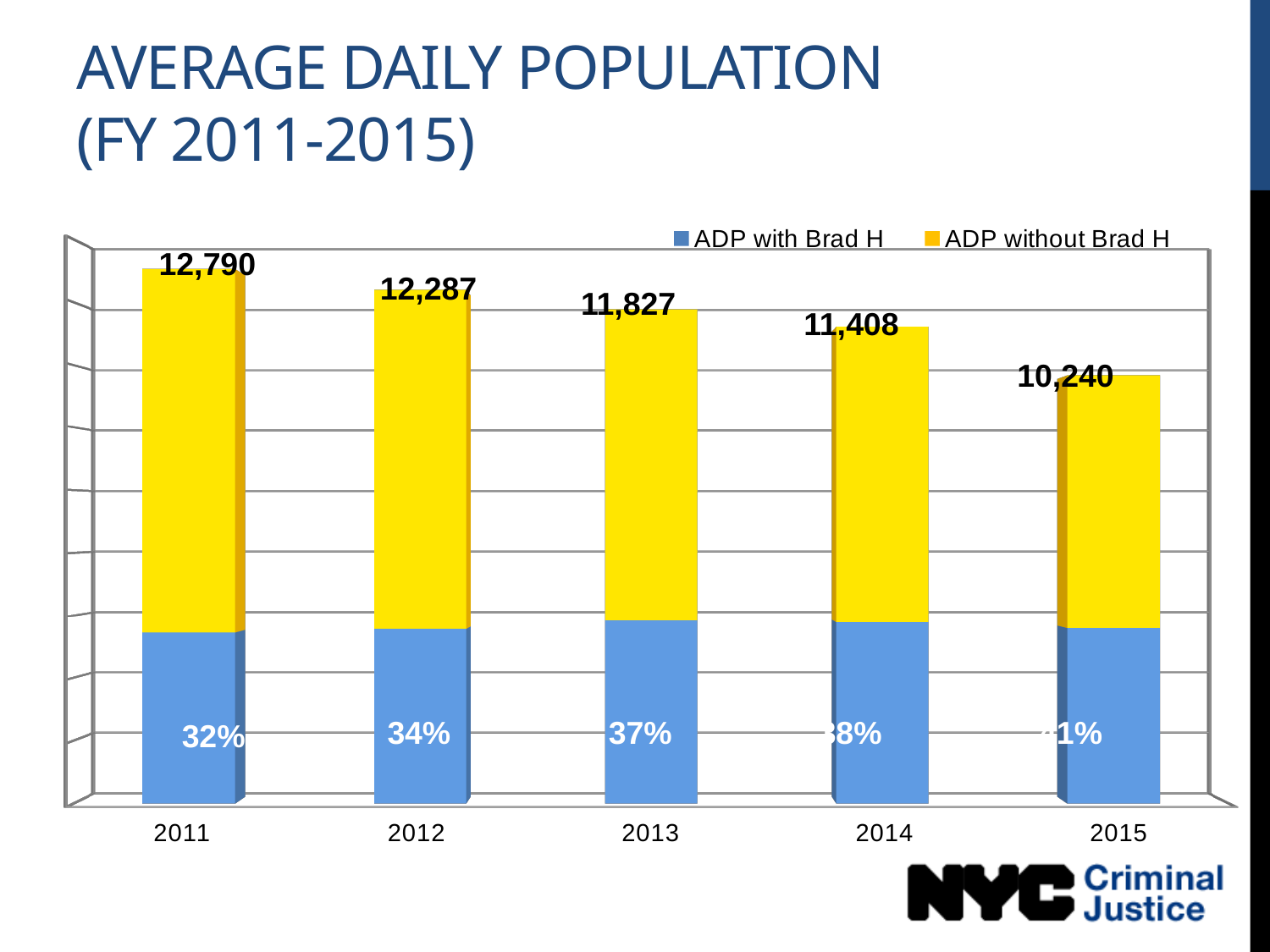
What type of chart is shown on the slide? stacked bar chart How many series does the legend list? 2 Do the labeled totals rise or fall from 2011 to 2015? fall What value is labeled above the bar for 2011? 12,790 What is the title of the chart on the slide? AVERAGE DAILY POPULATION (FY 2011-2015) Which year has the highest labeled total? 2011 What percentage is labeled on the ADP with Brad H segment for 2012? 34% What is the difference between the labeled totals for 2011 and 2015? 2,550 What value is labeled above the bar for 2013? 11,827 Which year has the lowest labeled total? 2015 What value is labeled above the bar for 2015? 10,240 How many years are shown on the x axis? 5